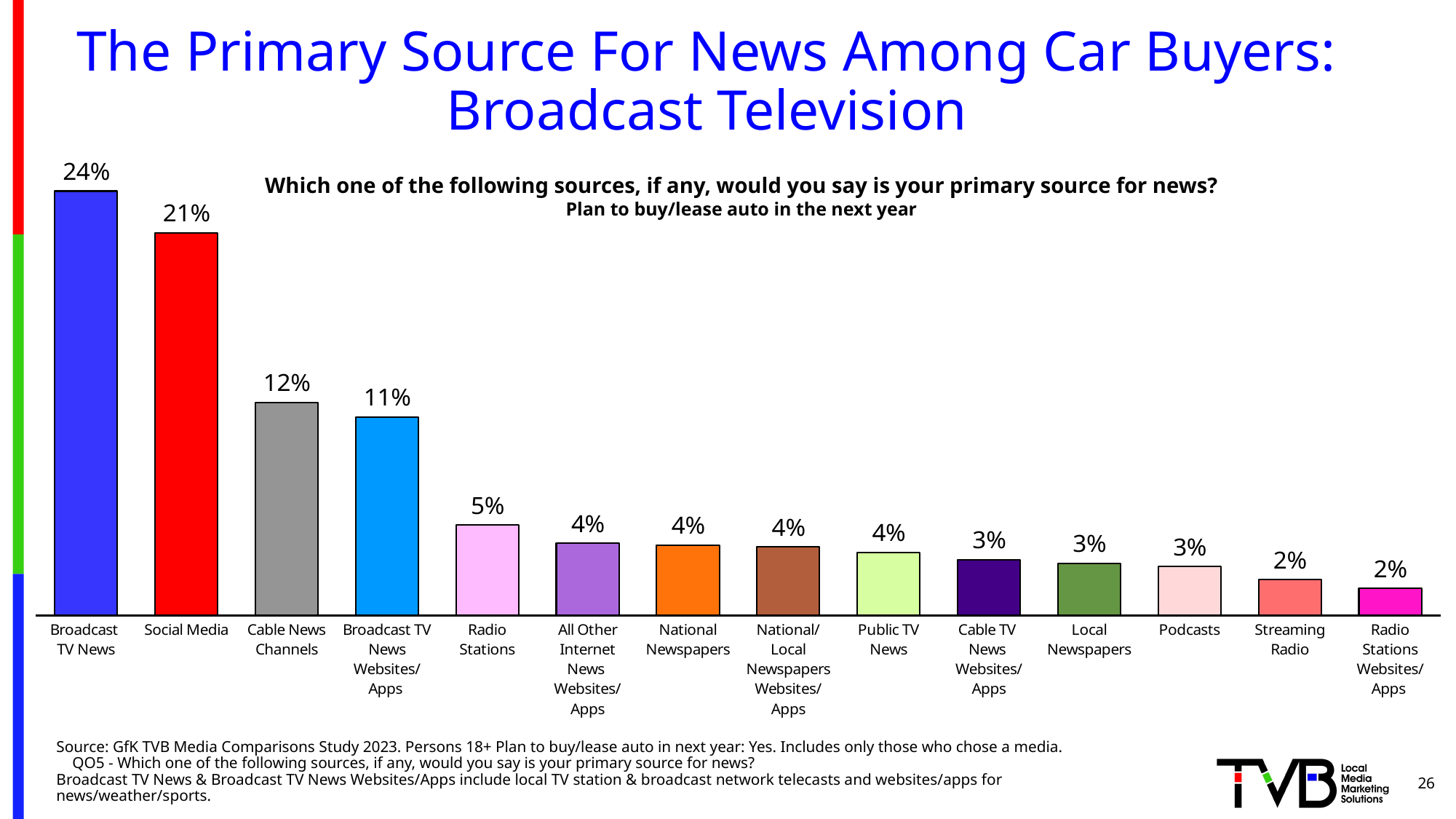
What is the value for Radio Stations? 5% How many news source categories are shown on the chart? 14 What percentage is shown for Cable News Channels? 12% Which news source has the highest value on the chart? Broadcast TV News Which is larger, the value for Cable News Channels or the value for Radio Stations? Cable News Channels What is the value shown for Social Media? 21% What is the difference between Cable News Channels and Broadcast TV News Websites/Apps? 1% What percentage of car buyers say Broadcast TV News is their primary source for news? 24% What value is shown for Podcasts? 3% What kind of chart is shown on the slide? Bar chart Do the values rise or fall moving from left to right across the chart? Fall What is the difference between the values for Broadcast TV News and Social Media? 3%